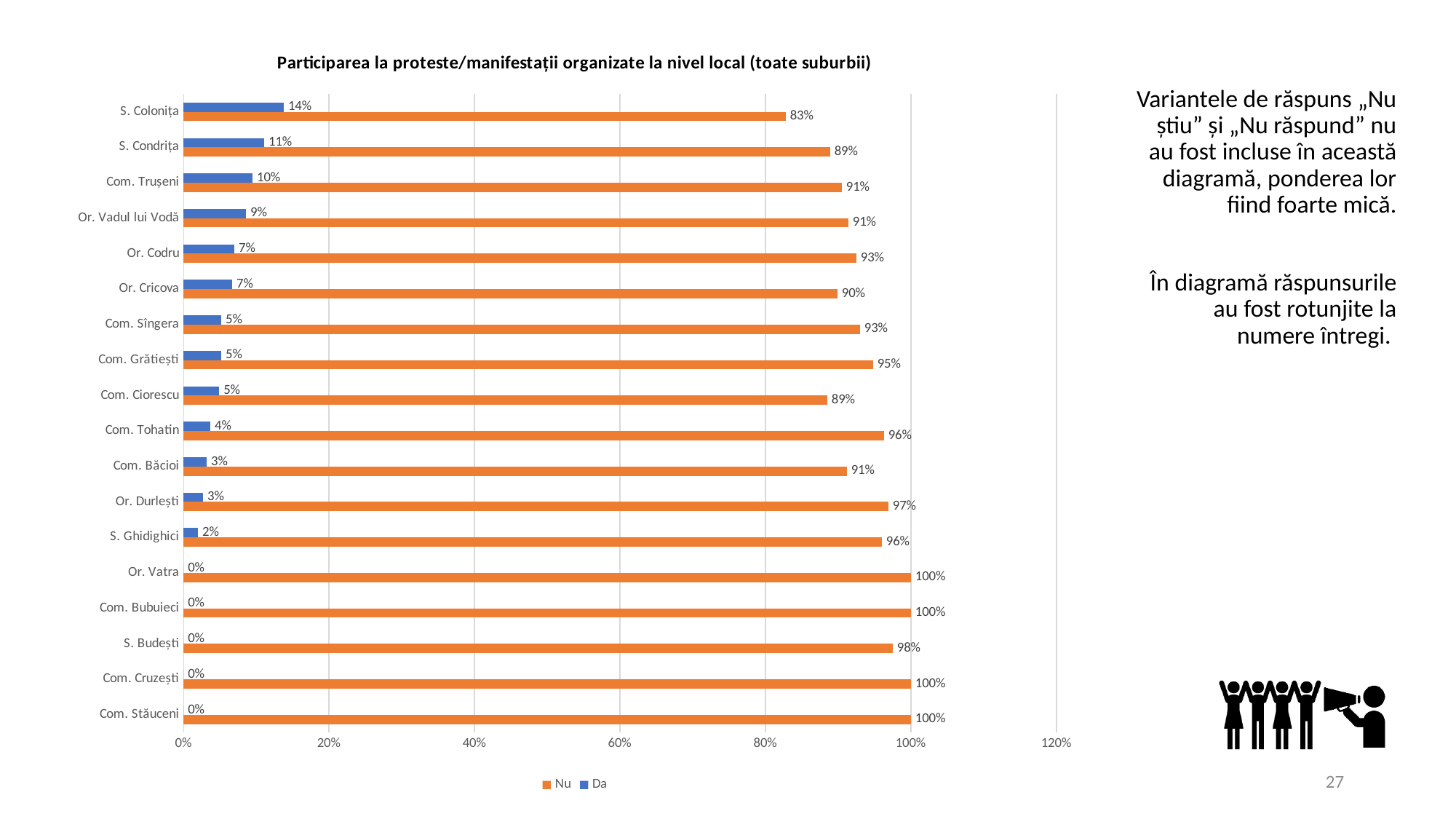
What is the total of the "Da" and "Nu" values for S. Colonița? 97% How many series does the legend list? 2 What is the difference between the "Da" values of S. Condrița and Com. Tohatin? 7% What is the "Nu" value for S. Budești? 98% What type of chart is shown on the slide? Bar chart Which locality has the lowest "Nu" value? S. Colonița What are the two series named in the legend? Nu and Da Which has a higher "Nu" value, Or. Durlești or Or. Cricova? Or. Durlești Which locality has the highest "Da" value? S. Colonița How many localities are shown on the chart? 18 What percentage of respondents in S. Colonița answered "Da"? 14% What is the "Nu" value for Com. Ciorescu? 89%